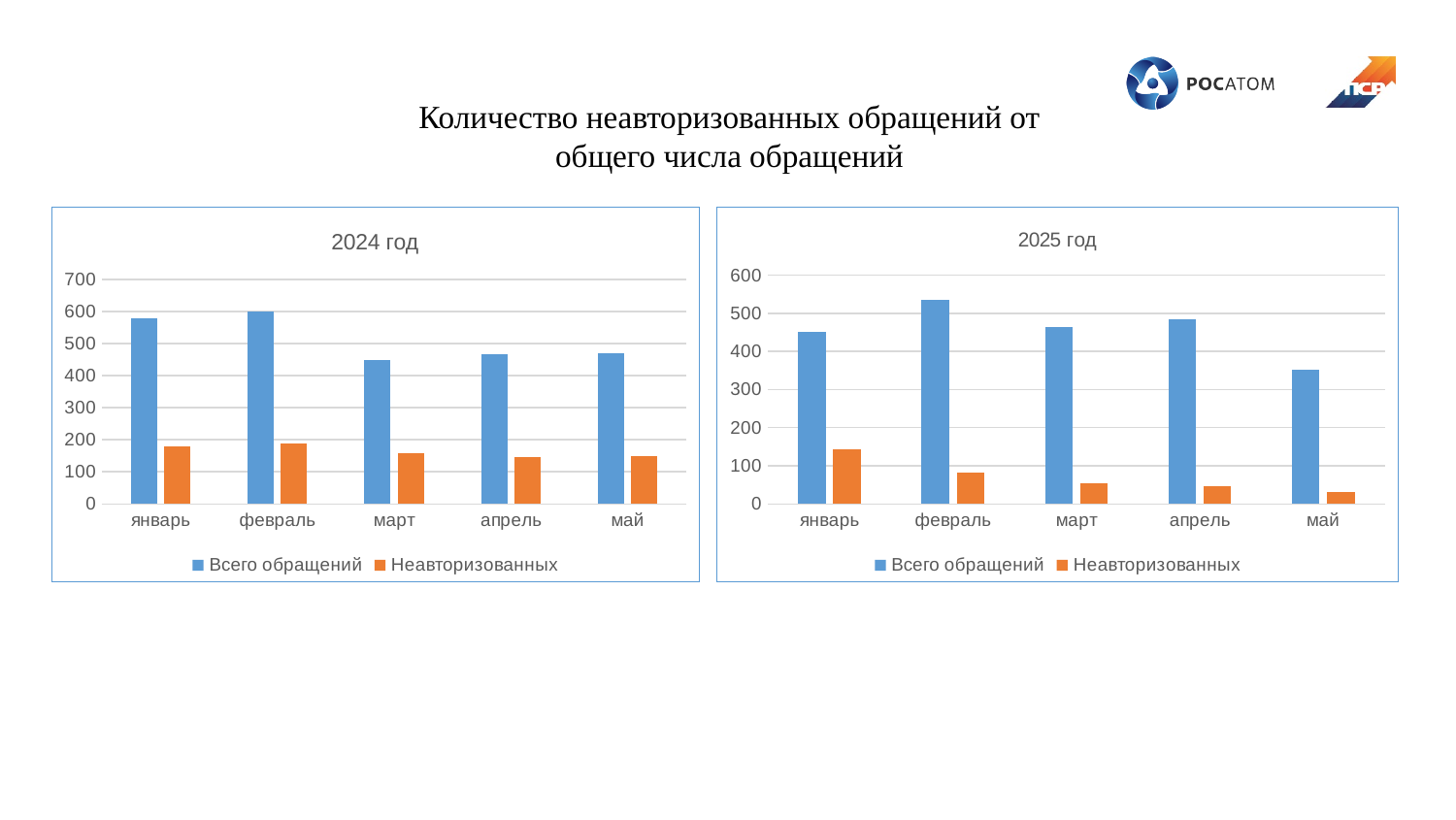
In the "2025 год" chart, which month has the lowest value for Неавторизованных? май In the "2025 год" chart, which is larger: Всего обращений in январь or in май? январь In the "2025 год" chart, which month has the lowest value for Всего обращений? май In the "2024 год" chart, is the value for Неавторизованных in март greater or less than 100? greater In the "2025 год" chart, do the values for Неавторизованных rise or fall from январь to май? fall How many months are shown on the x axis of the "2025 год" chart? 5 In the "2025 год" chart, which month has the highest value for Всего обращений? февраль What kind of chart is the "2024 год" chart? bar chart How many series does the legend of the "2024 год" chart list? 2 In the "2024 год" chart, is the value for Всего обращений in январь greater or less than 500? greater In the "2025 год" chart, is the value for Всего обращений in май greater or less than 400? less In the "2025 год" chart, which month has the highest value for Неавторизованных? январь